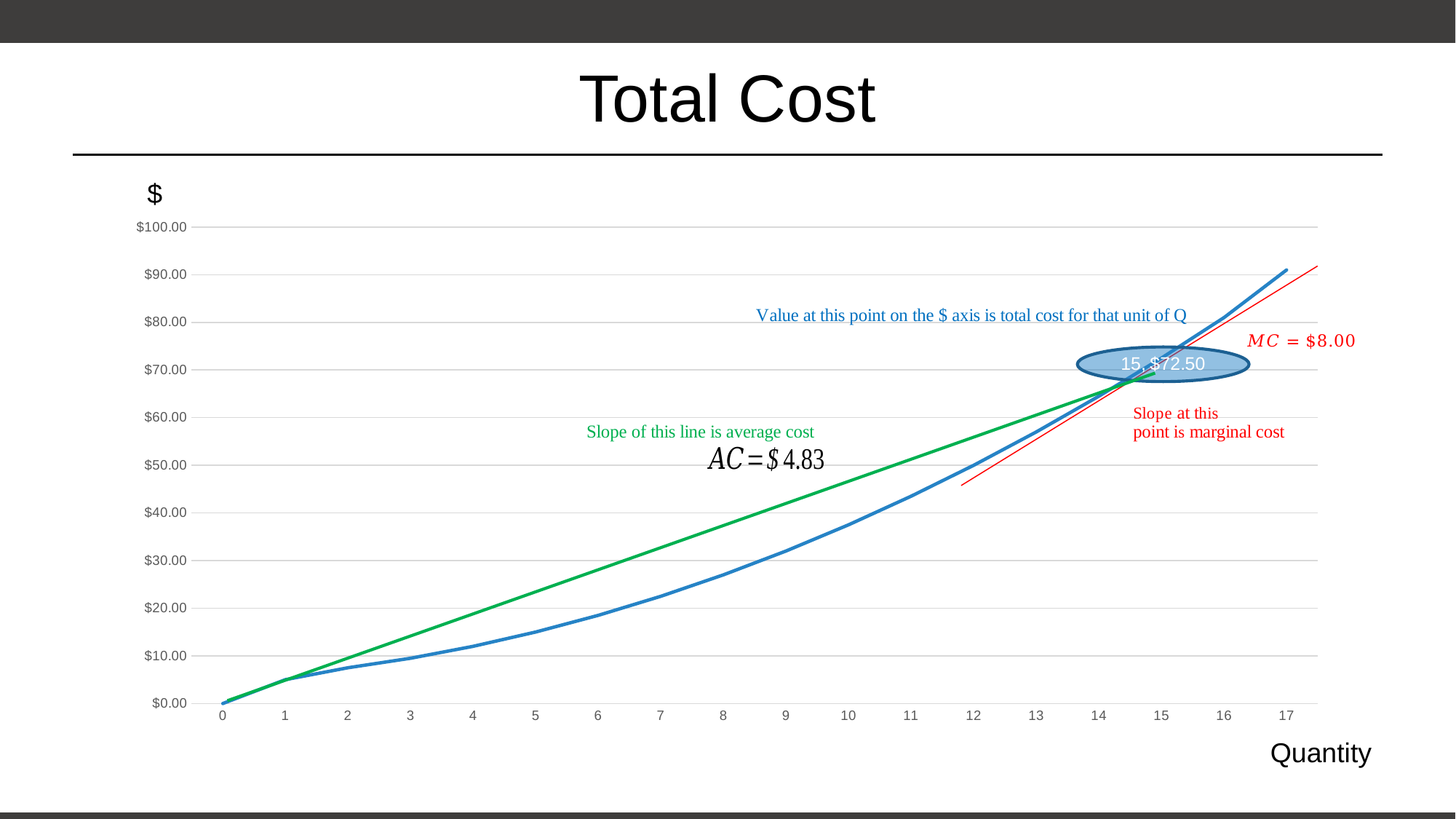
At which quantity is the total cost lowest? 0 What is the label on the horizontal axis of the chart? Quantity At which quantity is the total cost highest? 17 Which has the larger total cost, a quantity of 8 or a quantity of 12? 12 What is the total cost at a quantity of 0? $0.00 Is the total cost at a quantity of 17 greater or less than $80.00? greater Is the total cost at a quantity of 5 greater or less than $20.00? less Does the total cost rise or fall as quantity increases? rises What is the total cost at a quantity of 15? $72.50 Is the total cost at a quantity of 10 greater or less than $40.00? less What kind of chart is shown on the slide? line chart